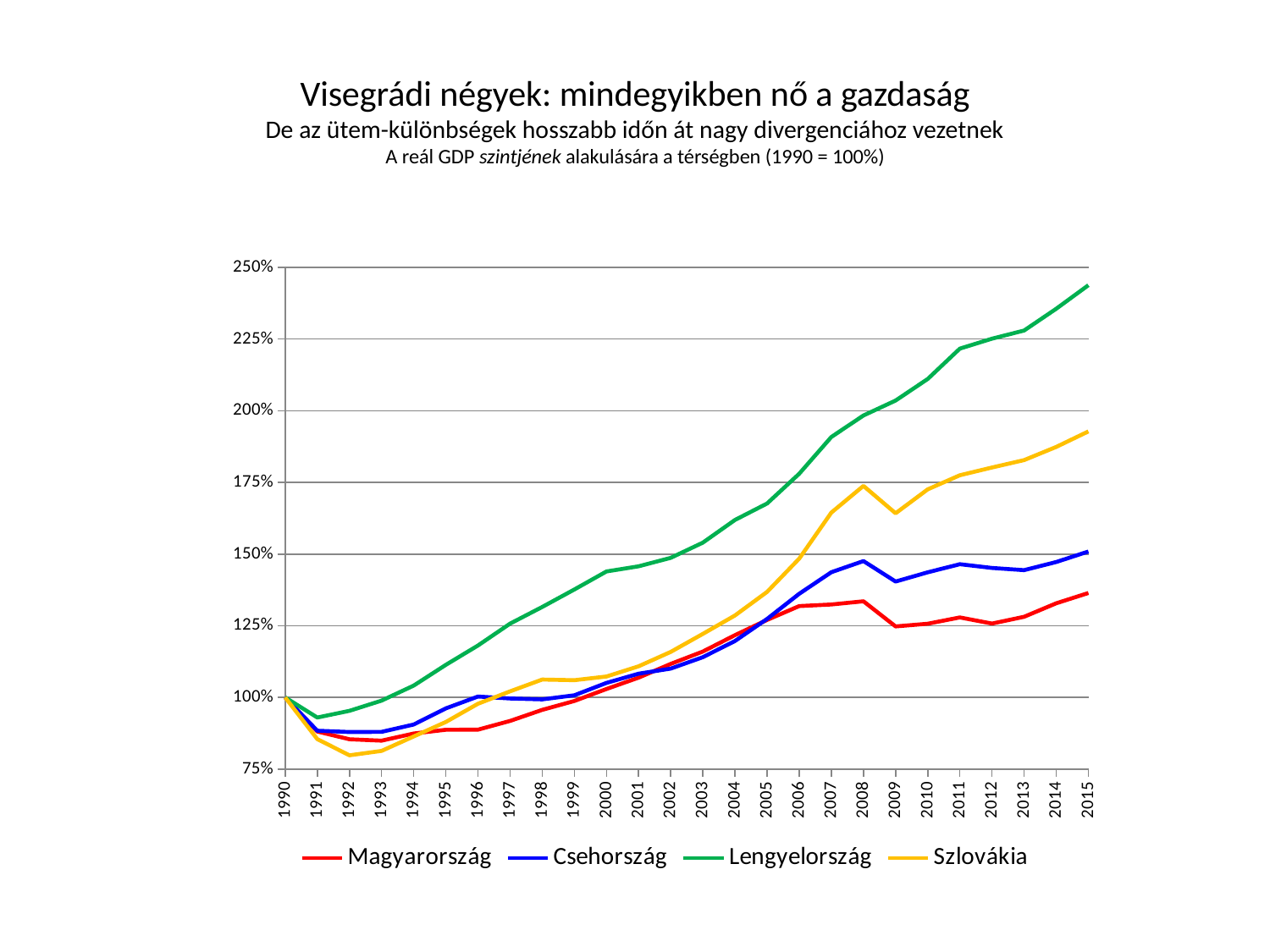
Which is larger in 2008, the value for Szlovákia or the value for Csehország? Szlovákia Which series has the highest value in 2015? Lengyelország Which series has the lowest value in 2015? Magyarország Is the value for Csehország in 2009 greater or less than 150%? less Which colour is used for the Magyarország series? red Is the value for Szlovákia in 1992 greater or less than 100%? less What kind of chart is shown on the slide? line chart How many years are plotted along the x axis? 26 What is the value for Magyarország in 1990? 100% How many series does the legend list? 4 Does the Lengyelország series generally rise or fall from 1993 to 2015? rise Is the value for Lengyelország in 2015 greater or less than 225%? greater